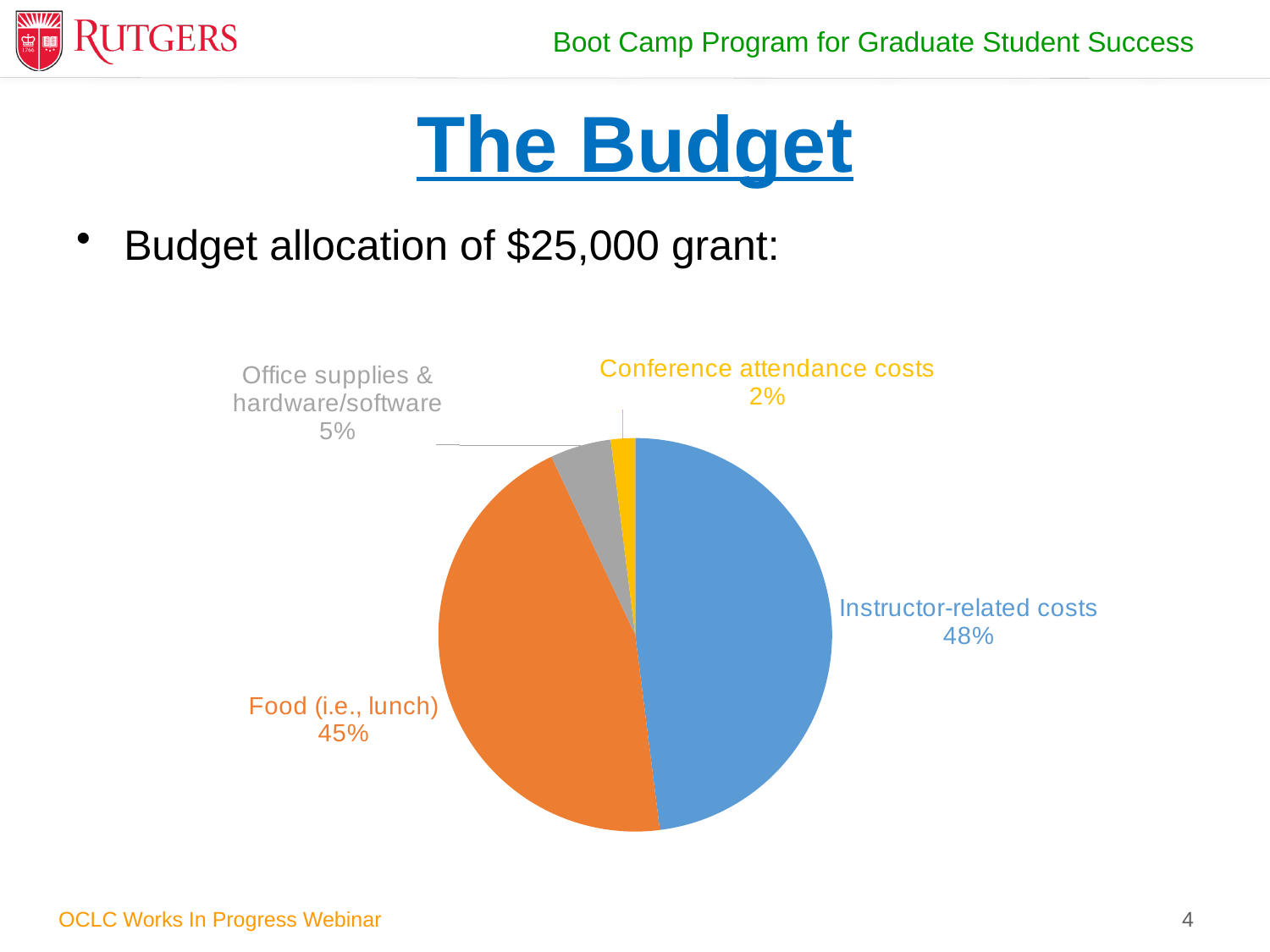
How many categories are shown in the pie chart? 4 Which is larger: the share for Office supplies & hardware/software or the share for Conference attendance costs? Office supplies & hardware/software What is the difference in percentage points between Instructor-related costs and Food (i.e., lunch)? 3 percentage points What share of the budget goes to Food (i.e., lunch)? 45% Which category has the smallest share of the budget? Conference attendance costs Which category has the largest share of the budget? Instructor-related costs What share of the budget goes to Instructor-related costs? 48% What share of the budget goes to Conference attendance costs? 2% What share of the budget goes to Office supplies & hardware/software? 5% What colour is the slice for Food (i.e., lunch)? Orange What kind of chart is shown on the slide? Pie chart What is the combined share of Instructor-related costs and Food (i.e., lunch)? 93%